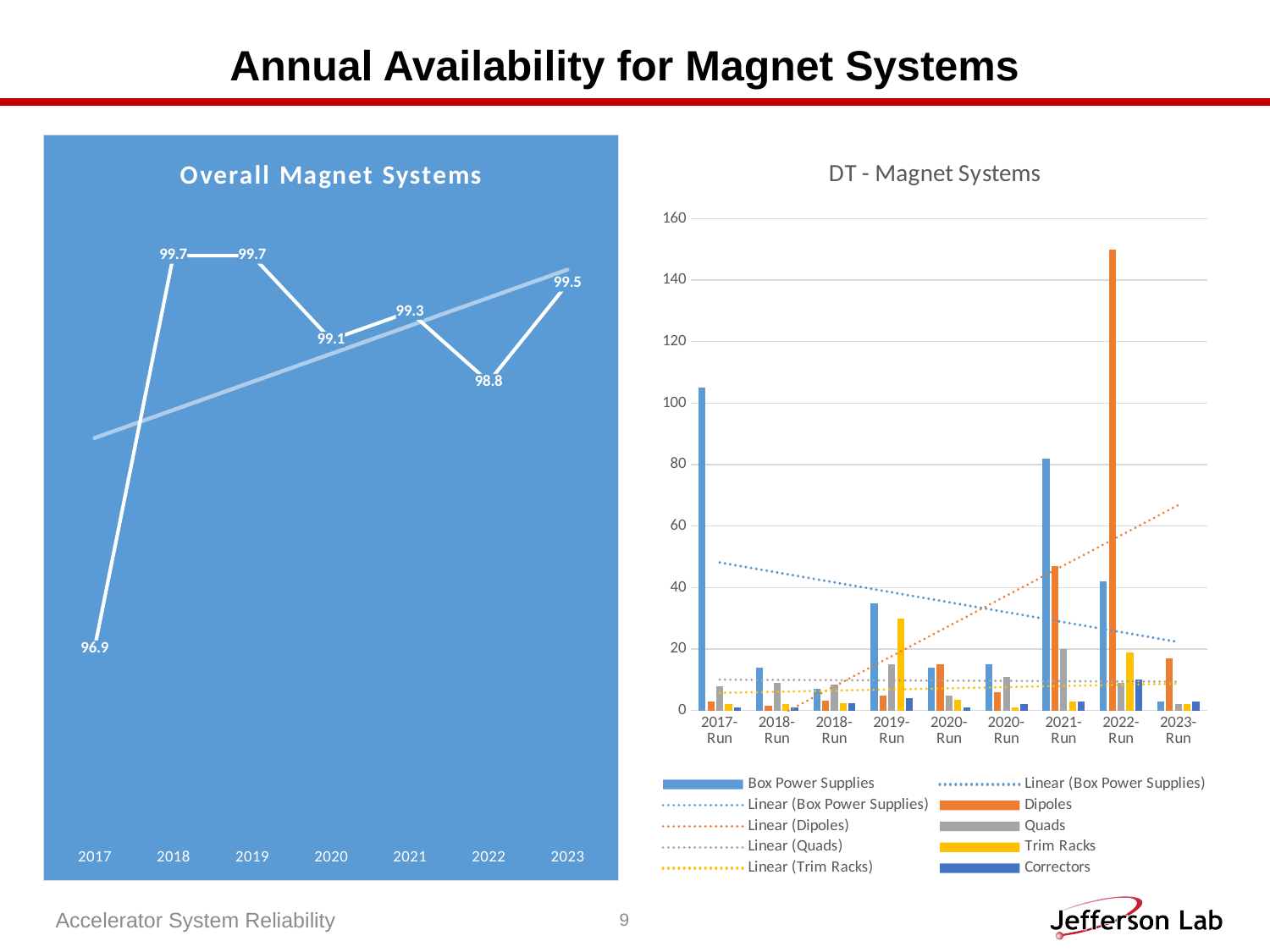
What kind of chart is the Overall Magnet Systems chart? line chart How many years are plotted in the Overall Magnet Systems chart? 7 In the Overall Magnet Systems chart, which year has the lowest value? 2017 In the DT - Magnet Systems chart, is the Dipoles value for 2022-Run greater or less than 140? greater In the Overall Magnet Systems chart, what is the difference between the 2018 value and the 2017 value? 2.8 How many run categories are shown on the x axis of the DT - Magnet Systems chart? 9 In the Overall Magnet Systems chart, what is the value for 2022? 98.8 What kind of chart is the DT - Magnet Systems chart? bar chart In the Overall Magnet Systems chart, which is larger, the value for 2020 or the value for 2021? 2021 In the DT - Magnet Systems chart, is the Box Power Supplies value for 2017-Run greater or less than 100? greater In the Overall Magnet Systems chart, what is the value for 2017? 96.9 In the Overall Magnet Systems chart, what is the value for 2023? 99.5